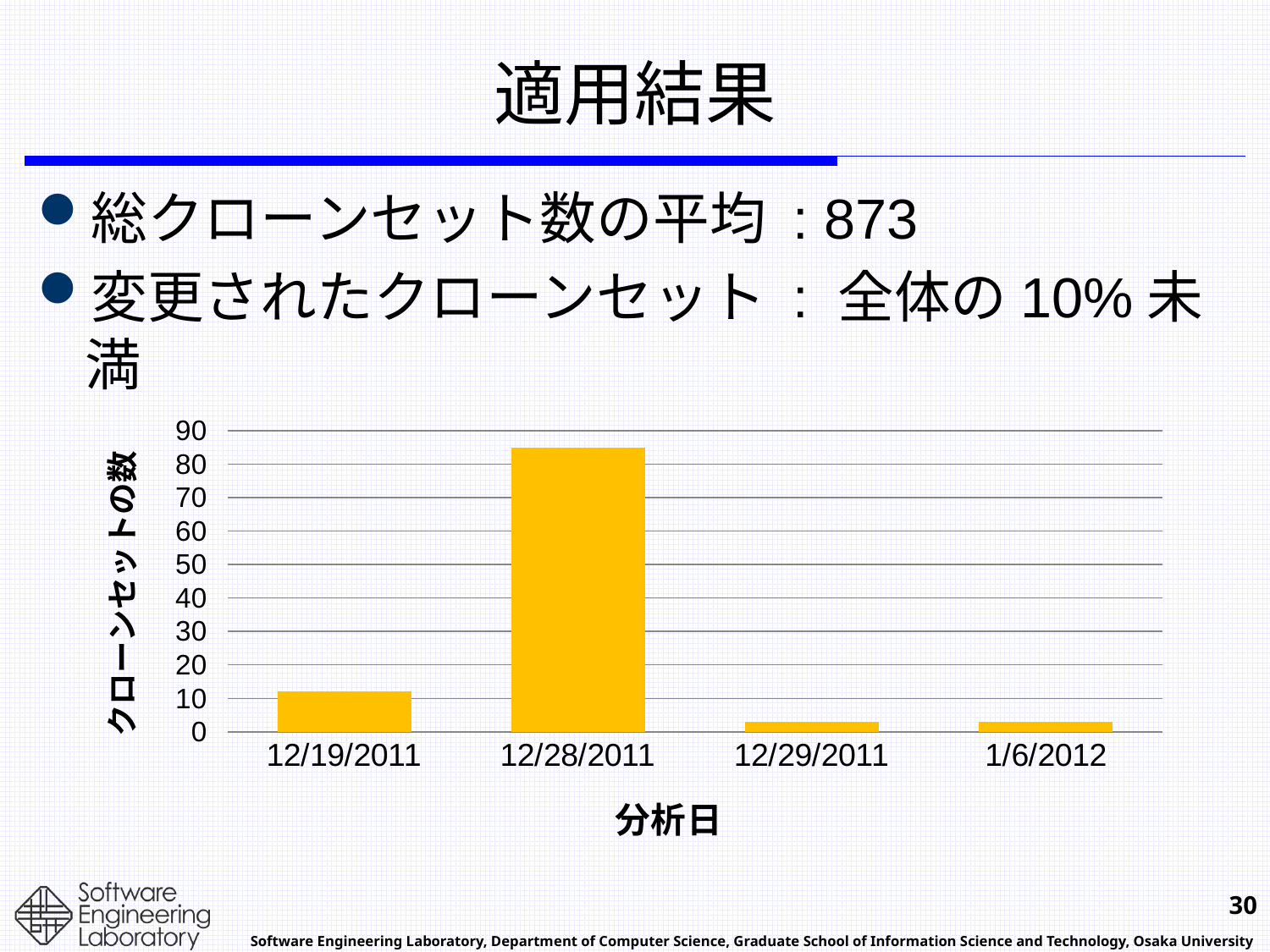
What is the title of the vertical axis of the chart? クローンセットの数 Which is larger, the value for 12/19/2011 or the value for 12/29/2011? 12/19/2011 What is the title of the horizontal axis of the chart? 分析日 Is the value for 1/6/2012 greater or less than 10? less Which is larger, the value for 12/28/2011 or the value for 1/6/2012? 12/28/2011 What kind of chart is shown on the slide? bar chart Which date has the highest number of clone sets in the chart? 12/28/2011 How many dates (categories) are shown on the x axis of the chart? 4 Is the value for 12/29/2011 greater or less than 10? less Is the value for 12/19/2011 greater or less than 20? less